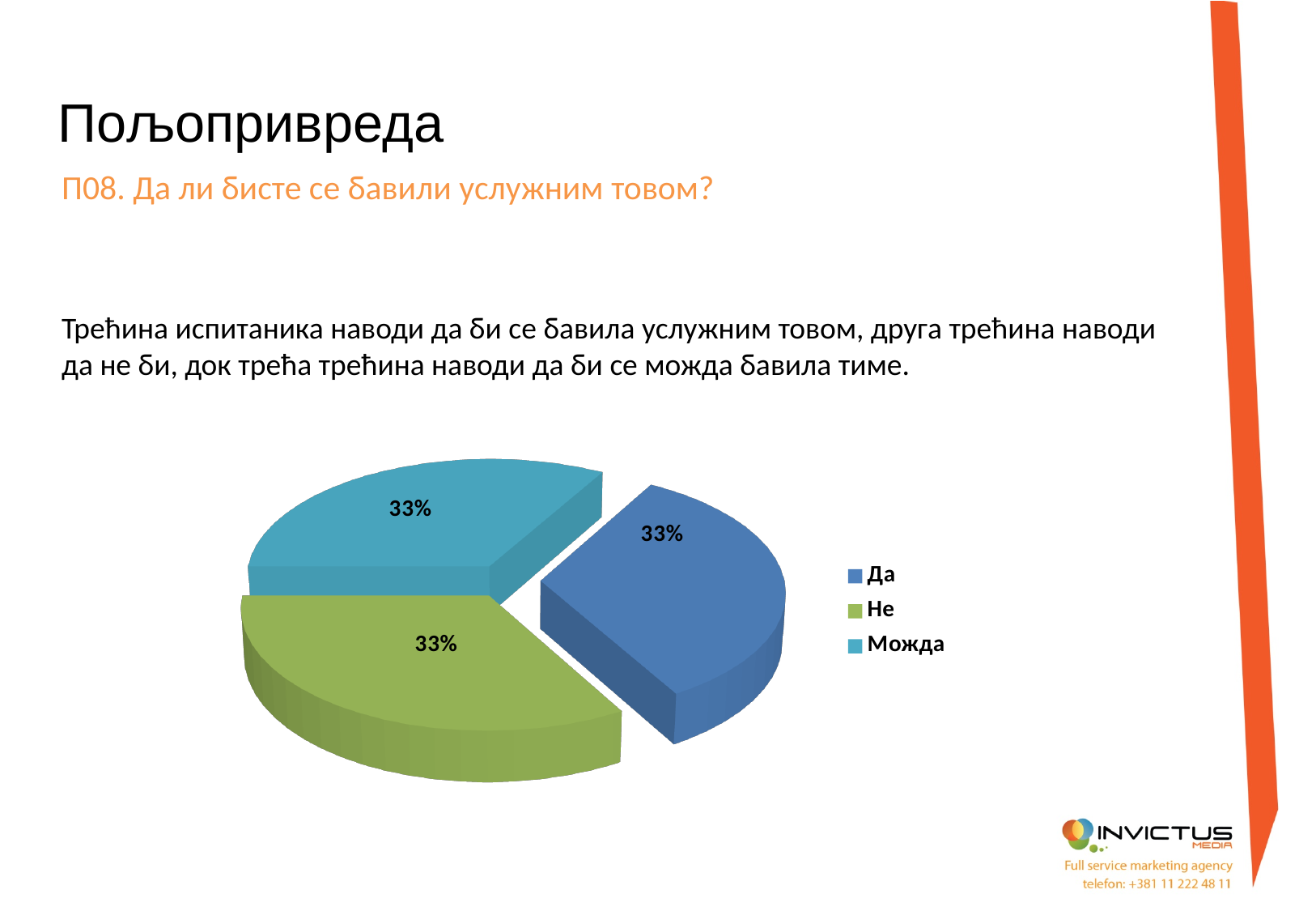
What share of the pie does the "Не" slice represent? 33% What is the value shown for the "Да" category in the pie chart? 33% How many slices does the pie chart have? 3 Which legend entry is shown in green in the pie chart? Не Which legend entry is shown in blue in the pie chart? Да What share of the pie does the "Можда" slice represent? 33% What kind of chart is shown on the slide? pie chart What share of the pie does the "Да" slice represent? 33% What is the value shown for the "Можда" category in the pie chart? 33% How many entries does the legend of the pie chart list? 3